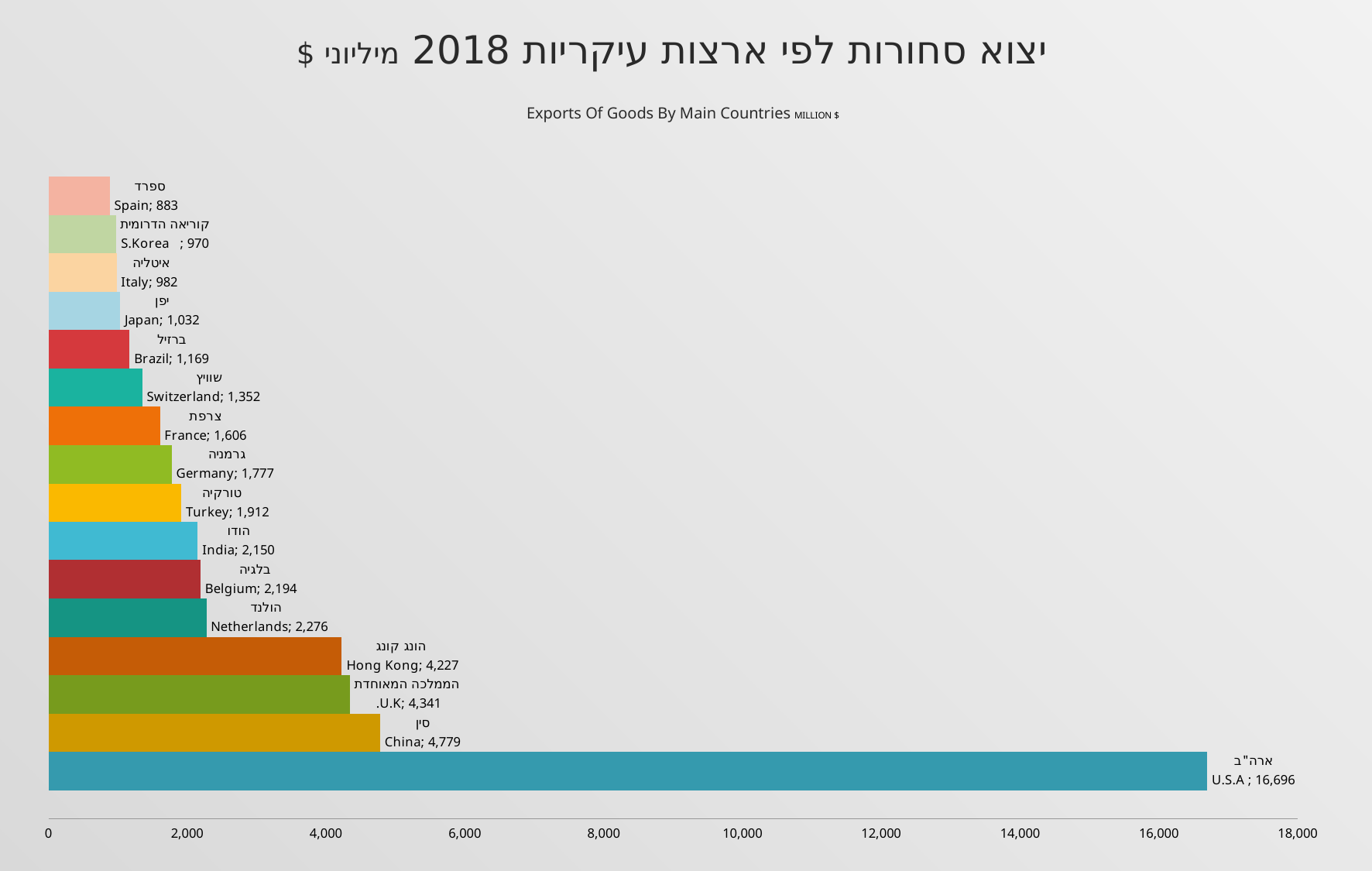
How many countries are shown in the chart? 16 What is the export value for China? 4,779 Which country has the highest export value? U.S.A What is the difference between the export values of the U.S.A and China? 11,917 Which country has the lowest export value? Spain What is the export value for Spain? 883 Is the export value for the Netherlands greater or less than 2,000? greater What is the difference between the export values of Germany and France? 171 What is the English title of the chart? Exports Of Goods By Main Countries What kind of chart is shown on the slide? bar chart What is the export value for Hong Kong? 4,227 Which has a larger export value, the U.K. or Hong Kong? U.K.